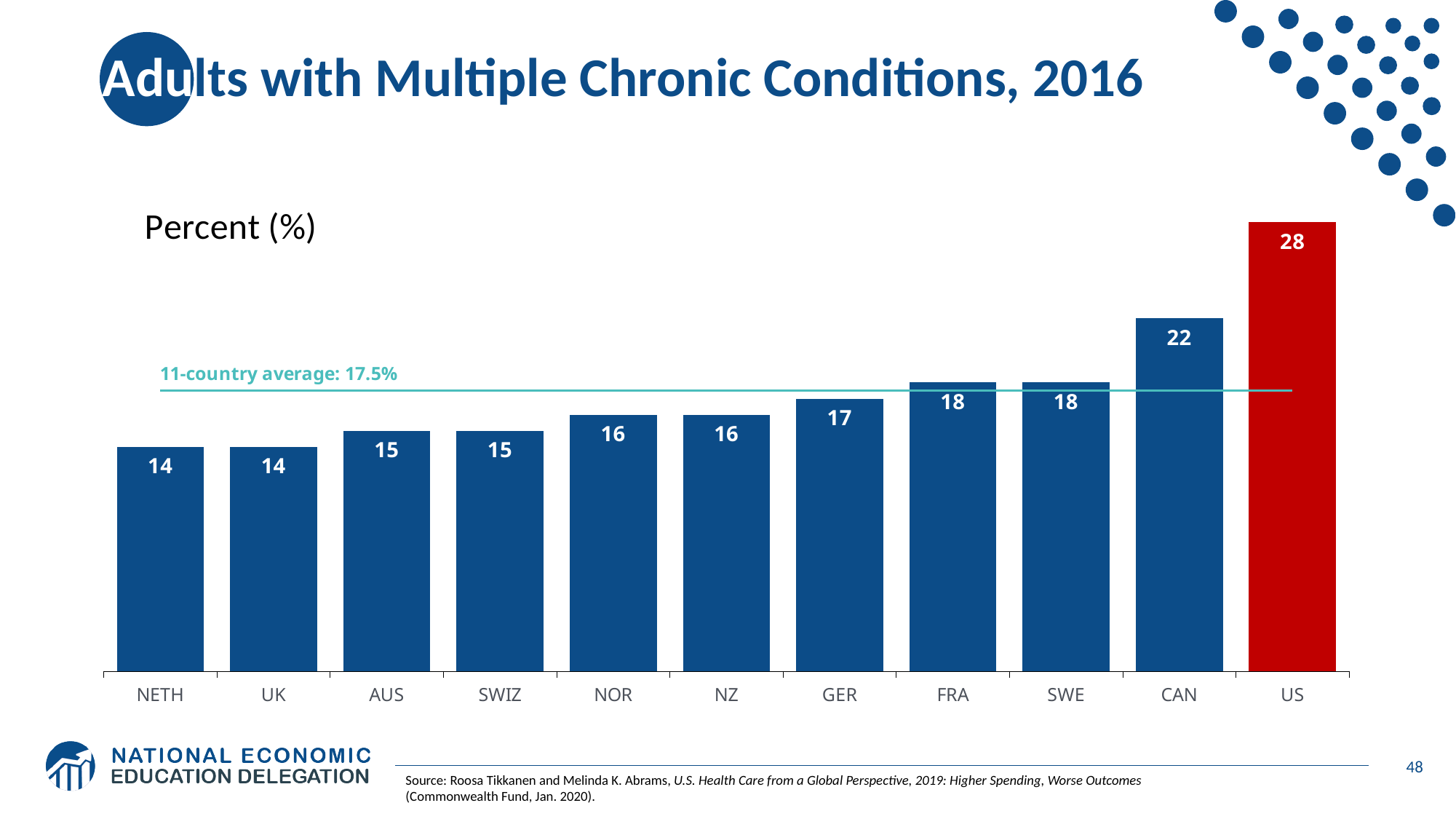
What is the 11-country average shown on the chart? 17.5% Which is larger, the value for CAN or the value for SWE? CAN How many countries are shown on the chart? 11 Which country has the highest value? US What is the difference between the values for the US and CAN? 6 What kind of chart is shown on the slide? bar chart What is the value for the US? 28 Do the values rise or fall from left to right across the countries? rise What is the difference between the values for FRA and NETH? 4 What is the value for GER? 17 What is the value for CAN? 22 Which country's bar is coloured red? US